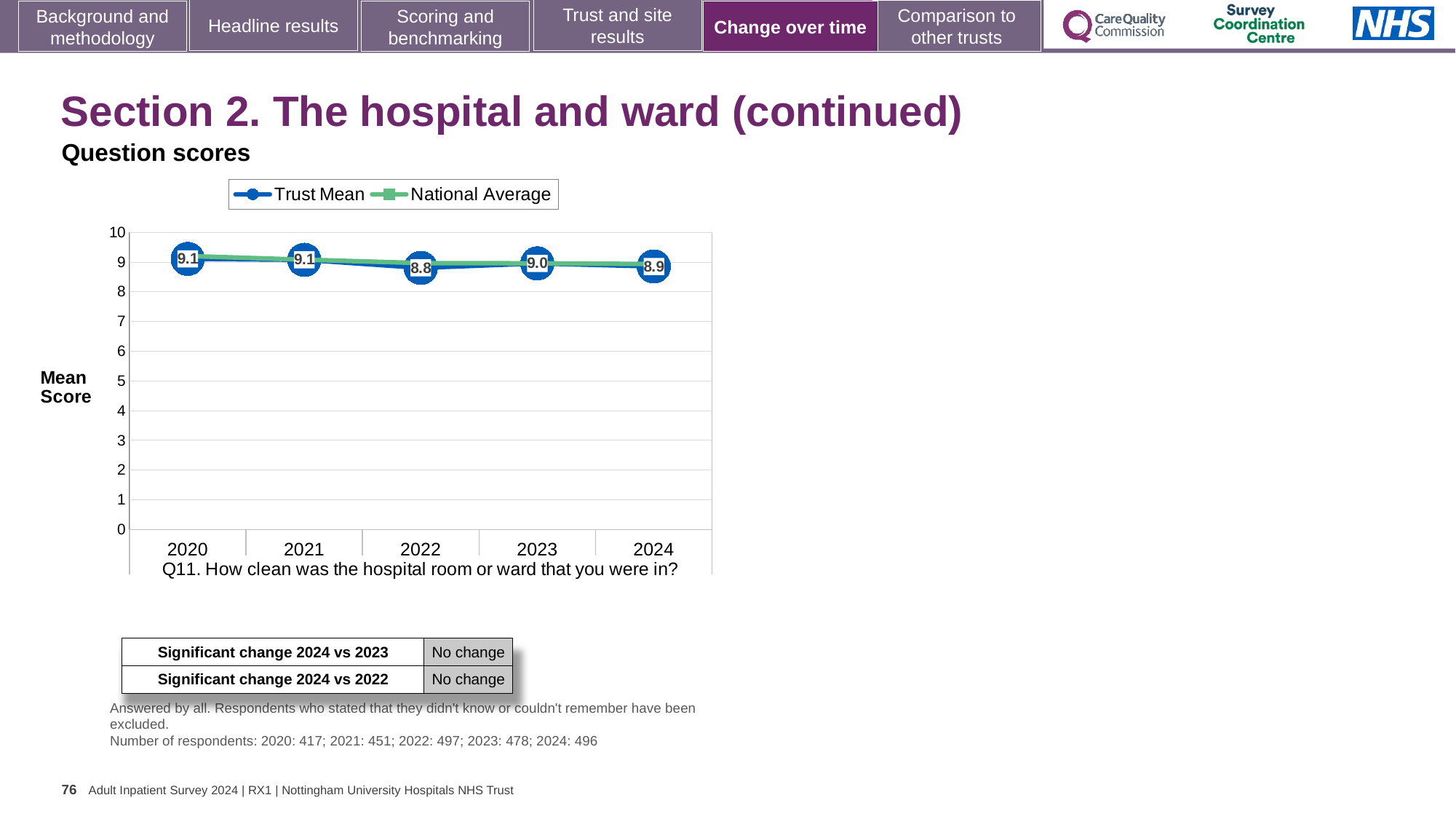
What is the Trust Mean value for 2022? 8.8 What is the Trust Mean value for 2023? 9.0 Is the National Average value for 2024 greater or less than 8? greater What is the Trust Mean value for 2024? 8.9 Which year has the larger Trust Mean, 2022 or 2023? 2023 How many years are plotted on the x axis? 5 In which year is the Trust Mean lowest? 2022 What kind of chart is shown on the slide? line chart What is the Trust Mean value for 2020? 9.1 How many series does the legend list? 2 What is the difference between the Trust Mean in 2021 and in 2022? 0.3 Which survey question does the chart show scores for? Q11. How clean was the hospital room or ward that you were in?